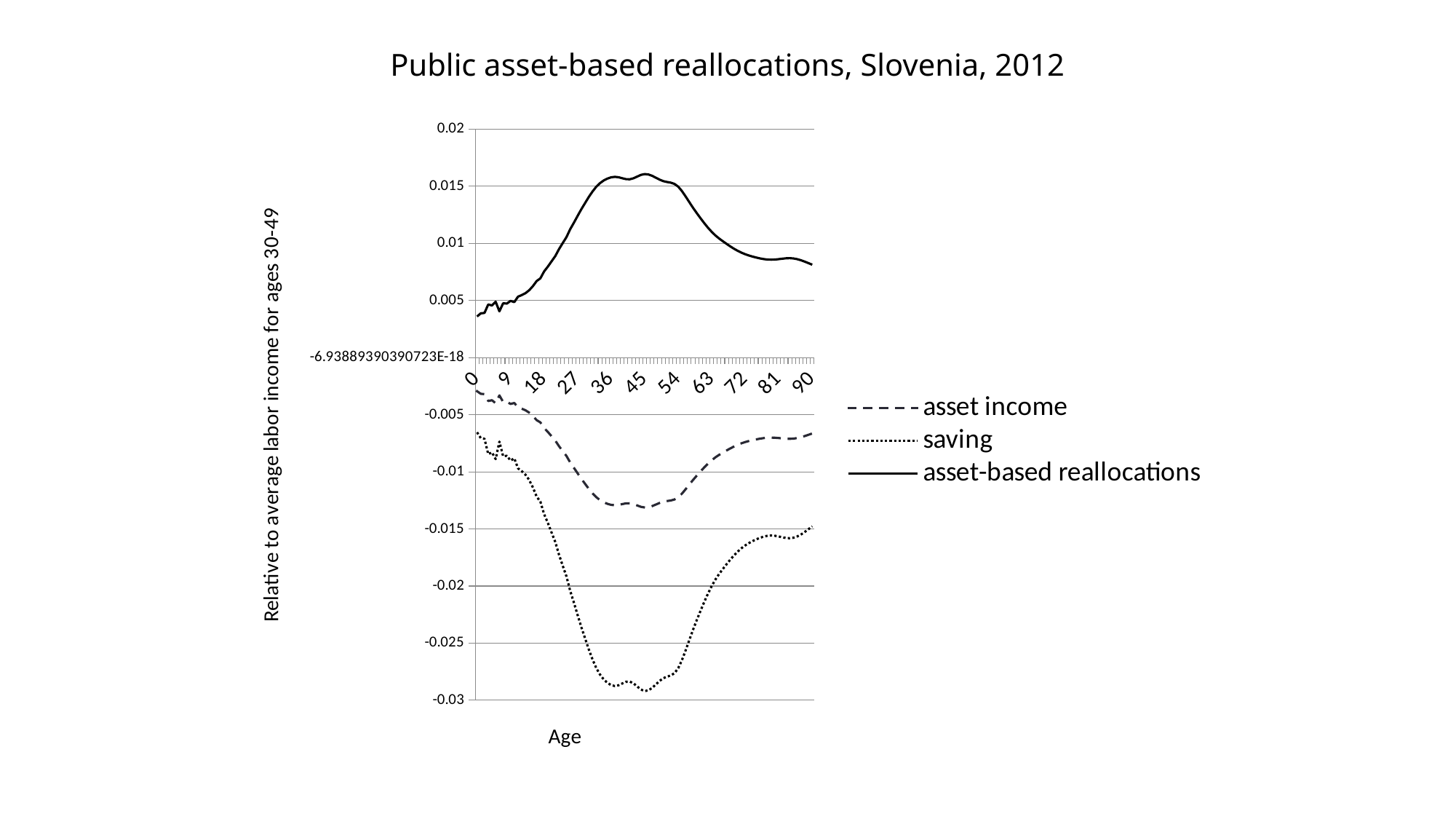
What are the three series named in the legend? asset income, saving, asset-based reallocations Does the saving line rise or fall between age 18 and age 36? fall Is the value of asset income at age 45 greater or less than -0.01? less Is the value of asset-based reallocations at age 45 greater or less than 0.015? greater Does the asset-based reallocations line rise or fall between age 54 and age 72? fall Is the value of saving at age 90 greater or less than -0.01? less What kind of chart is shown on the slide? line chart What is the title of the chart? Public asset-based reallocations, Slovenia, 2012 How many series does the legend list? 3 At age 45, which series has the lower value, saving or asset income? saving